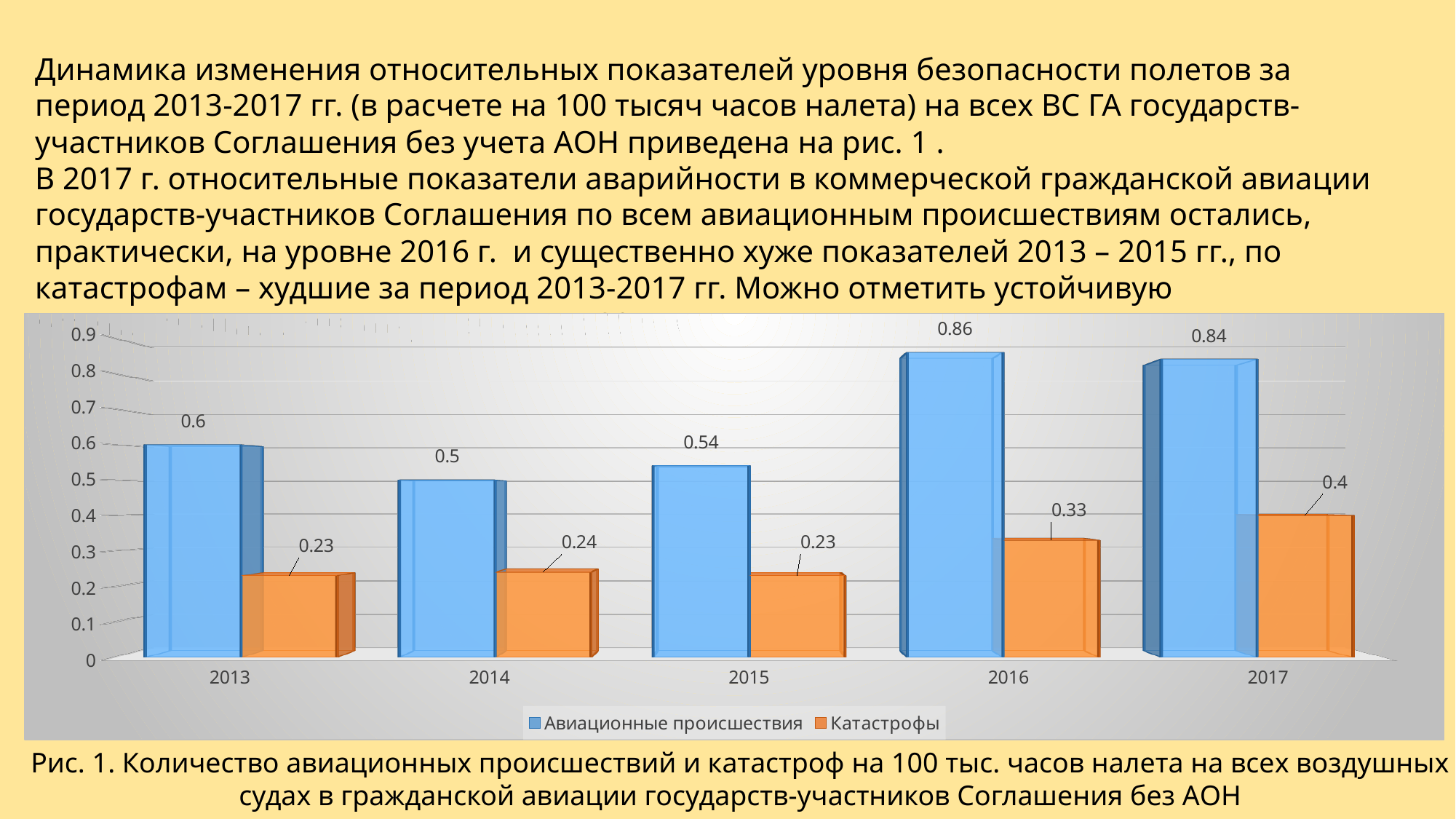
What is the difference between Авиационные происшествия and Катастрофы in 2017? 0.44 Which year has the highest value for Авиационные происшествия? 2016 What kind of chart is shown on the slide? Bar chart Which is larger: Катастрофы in 2016 or Катастрофы in 2015? Катастрофы in 2016 How many years are shown on the x axis? 5 Which year has the highest value for Катастрофы? 2017 How many series does the legend list? 2 What is the value for Катастрофы in 2014? 0.24 What is the value for Авиационные происшествия in 2016? 0.86 What is the value for Авиационные происшествия in 2013? 0.6 Which year has the lowest value for Авиационные происшествия? 2014 Which colour represents Катастрофы in the chart? Orange